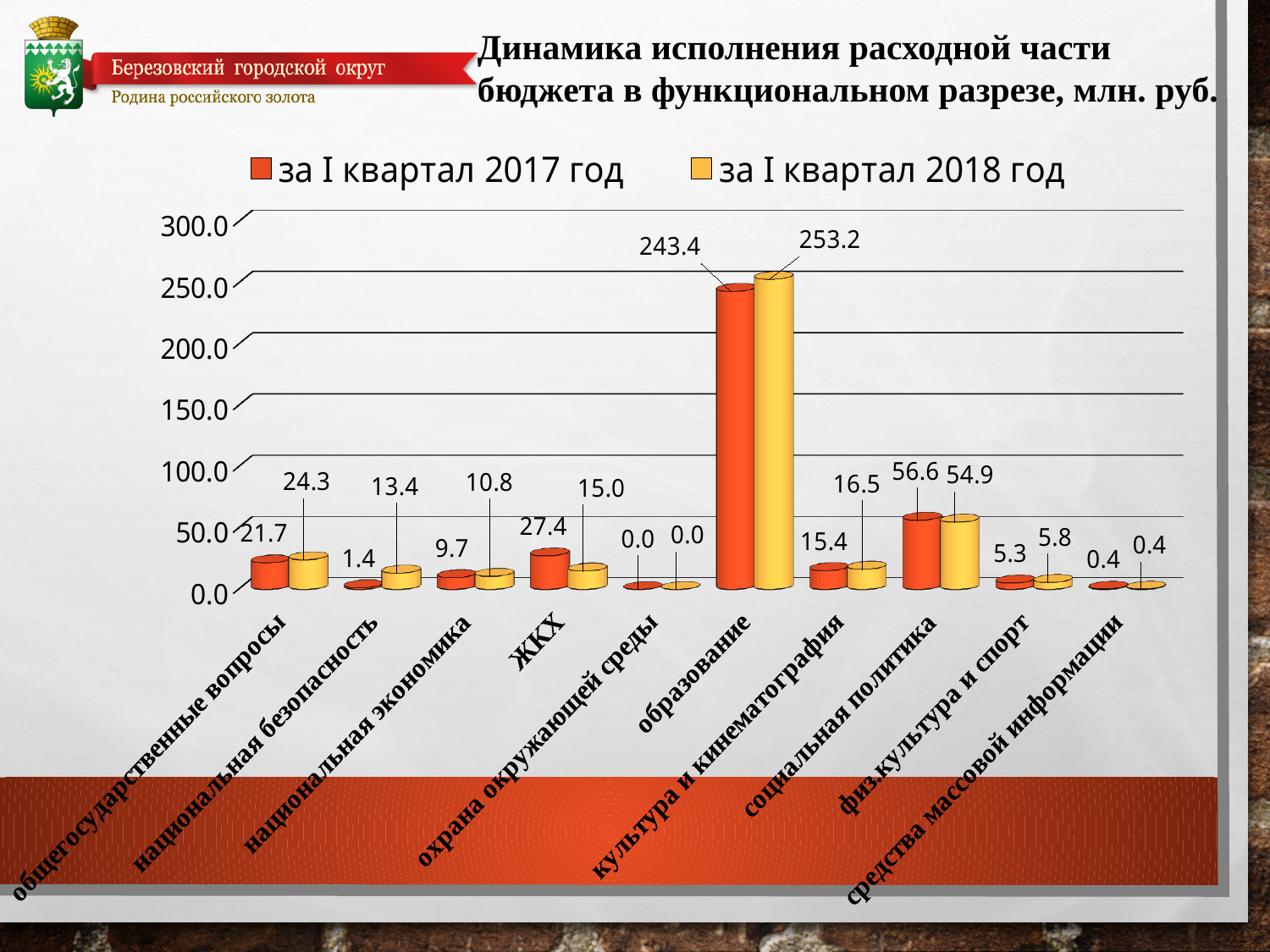
What is the difference between the за I квартал 2018 год and за I квартал 2017 год values for образование? 9.8 How many series does the legend list? 2 How many categories are shown on the x axis of the chart? 10 What value is shown for национальная безопасность for за I квартал 2018 год? 13.4 What is the difference between the за I квартал 2018 год and за I квартал 2017 год values for национальная безопасность? 12.0 What kind of chart is shown on the slide? bar chart For социальная политика, which is larger: the за I квартал 2017 год value or the за I квартал 2018 год value? за I квартал 2017 год For ЖКХ, which is larger: the за I квартал 2017 год value or the за I квартал 2018 год value? за I квартал 2017 год What value is shown for образование for за I квартал 2018 год? 253.2 Which category has the highest value for за I квартал 2017 год? образование Which category has the lowest value for за I квартал 2018 год? охрана окружающей среды What value is shown for ЖКХ for за I квартал 2017 год? 27.4